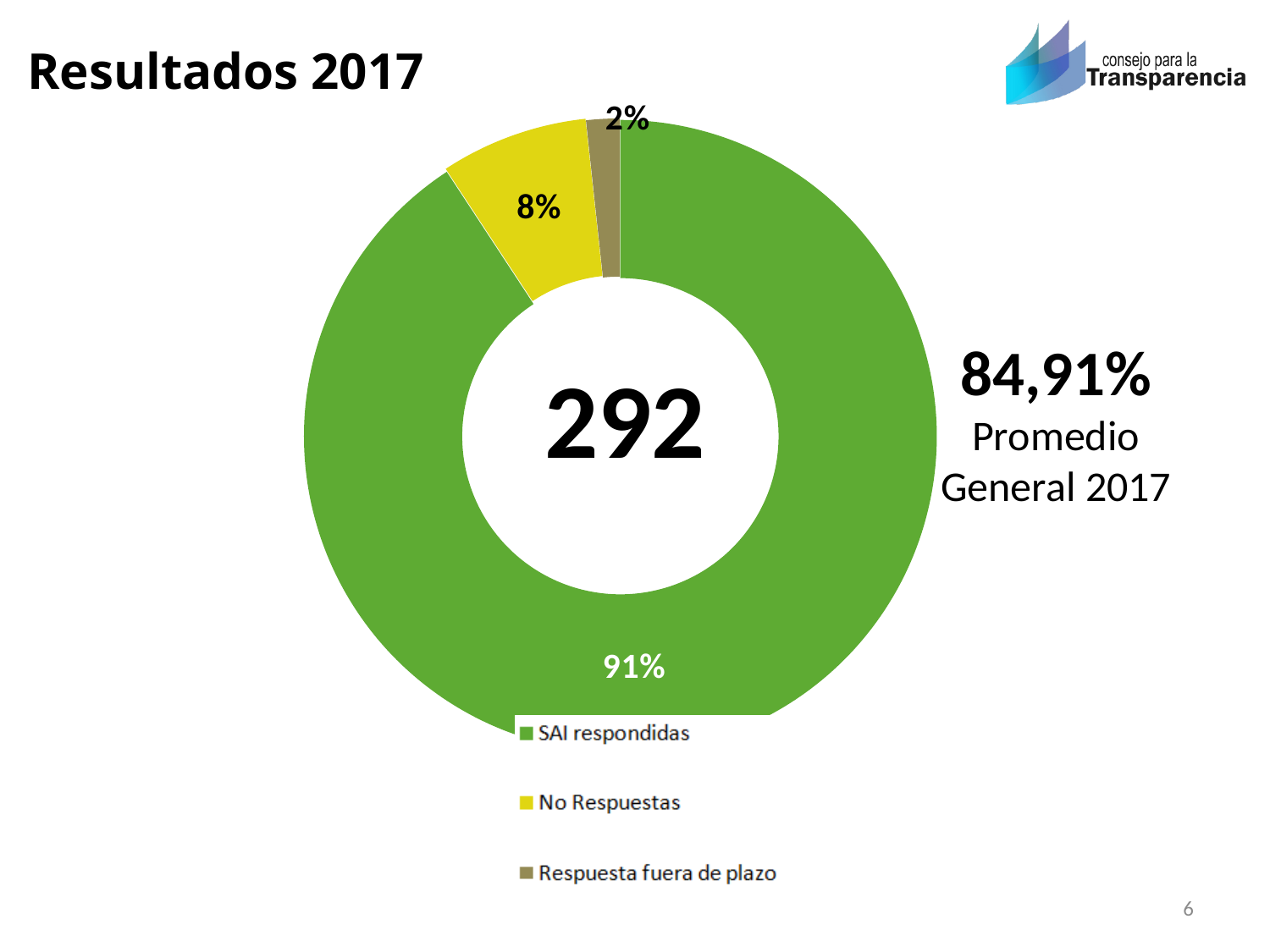
What percentage is shown for No Respuestas? 8% How many categories does the legend list? 3 Which category has the largest share of the chart? SAI respondidas Which category has the smallest share of the chart? Respuesta fuera de plazo What kind of chart is shown on the slide? Doughnut (pie) chart Which is larger, the share for No Respuestas or the share for Respuesta fuera de plazo? No Respuestas What number is printed in the centre of the doughnut chart? 292 What percentage is shown for Respuesta fuera de plazo? 2% What is the difference in percentage points between SAI respondidas and No Respuestas? 83 percentage points What percentage is shown for SAI respondidas? 91% What colour represents No Respuestas in the chart? Yellow